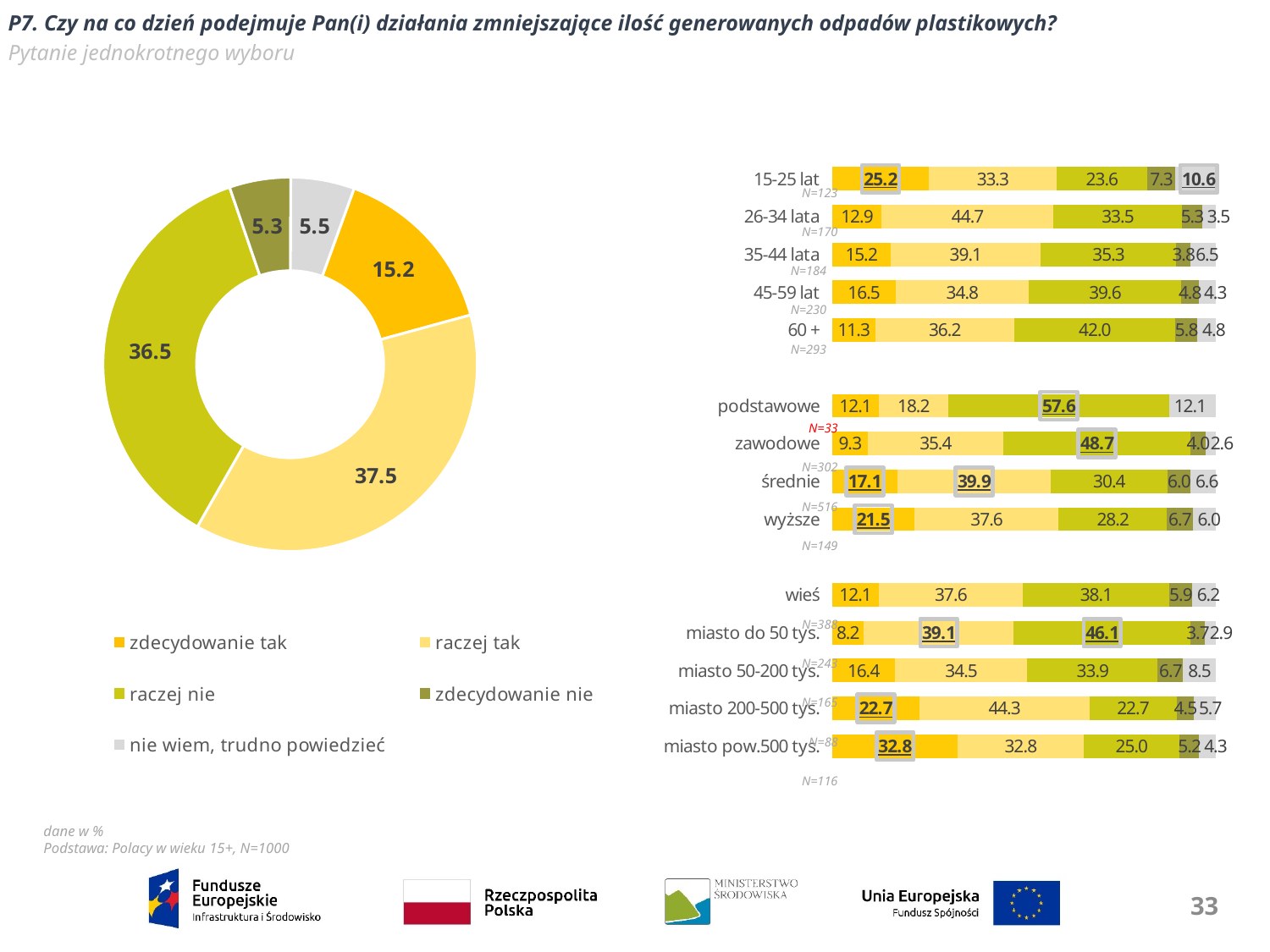
On the donut chart on the left, which is larger: "zdecydowanie tak" or "nie wiem, trudno powiedzieć"? zdecydowanie tak On the donut chart on the left, what is the difference between "raczej tak" and "raczej nie"? 1.0 How many entries does the legend of the donut chart on the left list? 5 On the bar chart on the right, what is the "zdecydowanie tak" value for "miasto pow.500 tys."? 32.8 On the bar chart on the right, what is the "raczej nie" value for "podstawowe"? 57.6 What kind of chart is on the right side of the slide? stacked bar chart On the donut chart on the left, what is the value for "raczej tak"? 37.5 On the bar chart on the right, which is larger: the "raczej nie" value for "wieś" or for "miasto do 50 tys."? miasto do 50 tys. On the bar chart on the right, how many age groups are shown? 5 On the bar chart on the right, what is the difference between the "raczej tak" values for "26-34 lata" and "60 +"? 8.5 On the donut chart on the left, which category has the smallest value? zdecydowanie nie On the bar chart on the right, which age group has the highest "zdecydowanie tak" value? 15-25 lat